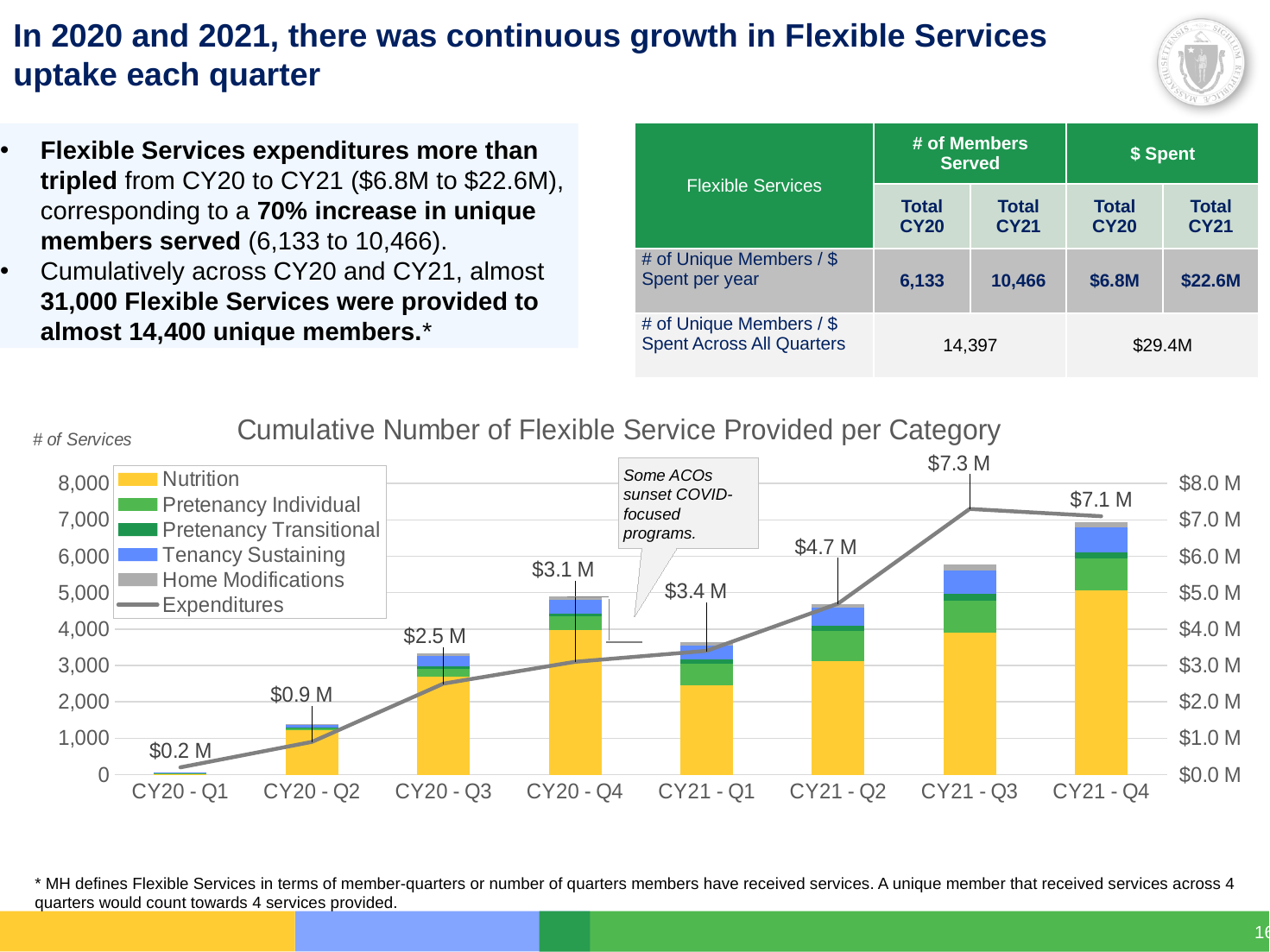
In which quarter are Expenditures lowest? CY20 - Q1 What is the Expenditures value for CY21 - Q2? $4.7 M How many quarters are shown on the x axis? 8 What is the title of the chart? Cumulative Number of Flexible Service Provided per Category Do Expenditures generally rise or fall from CY20 - Q1 to CY21 - Q3? rise In which quarter are Expenditures highest? CY21 - Q3 How many series does the legend list? 6 What is the Expenditures value for CY20 - Q4? $3.1 M Which quarter has higher Expenditures, CY21 - Q3 or CY21 - Q4? CY21 - Q3 What is the Expenditures value for CY20 - Q1? $0.2 M What is the difference in Expenditures between CY21 - Q2 and CY21 - Q1? $1.3 M Is the total number of services for CY21 - Q4 greater or less than 6,000? greater